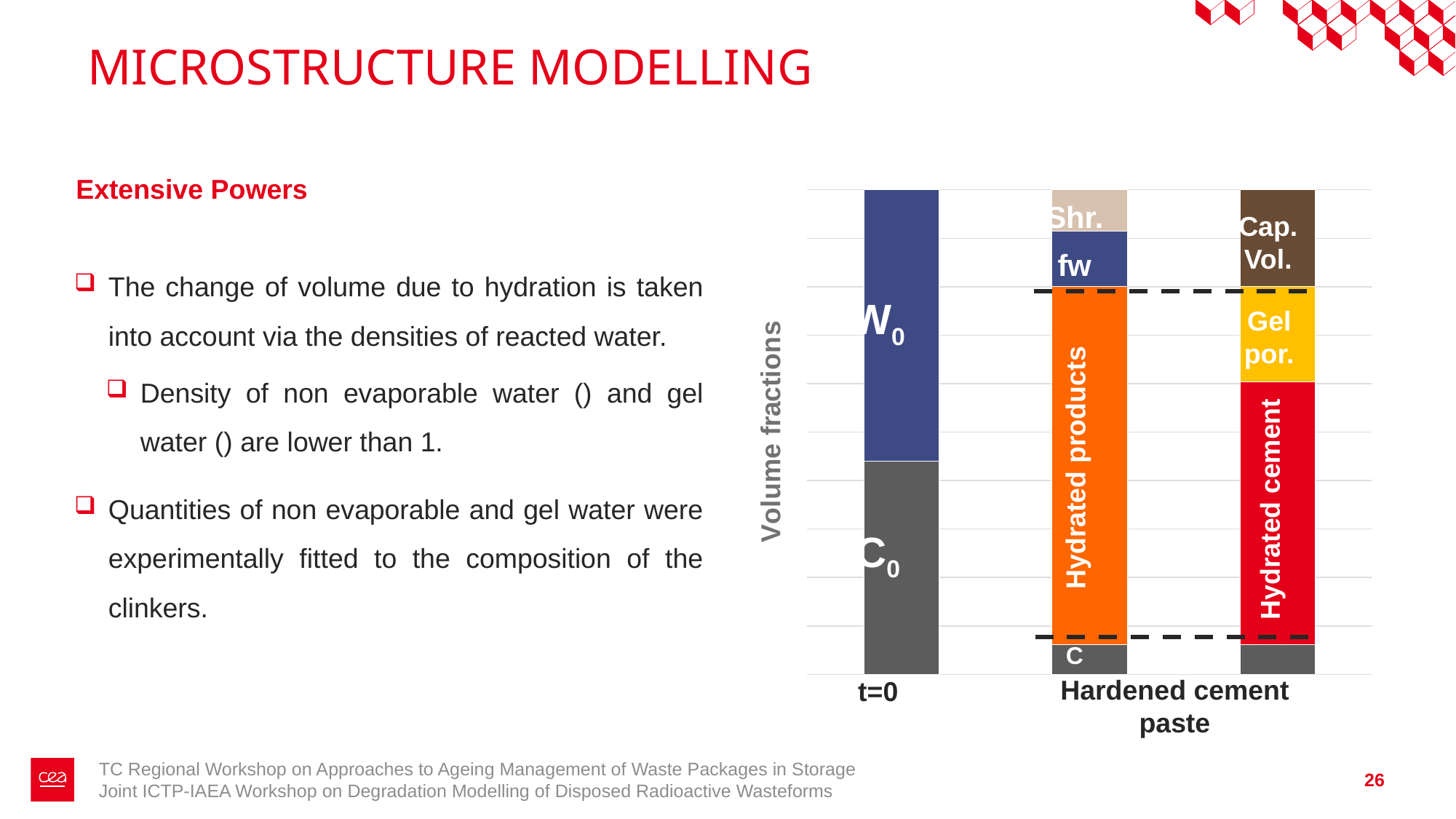
How many bars are plotted in the chart? 3 Which segment is the largest in the middle bar? Hydrated products In the right-hand bar, which segment is larger, Gel por. or Hydrated cement? Hydrated cement Which segment is the largest in the right-hand bar? Hydrated cement In the middle bar, which segment is smaller, fw or Hydrated products? fw Which segment is at the bottom of the t=0 bar? C0 Which segment is at the top of the middle bar? Shr. What is the label of the vertical axis of the chart? Volume fractions In the t=0 bar, which segment is larger, W0 or C0? W0 What kind of chart is shown on the slide? Stacked bar chart What are the two category labels shown on the horizontal axis of the chart? t=0 and Hardened cement paste Which segment is at the top of the right-hand bar? Cap. Vol.